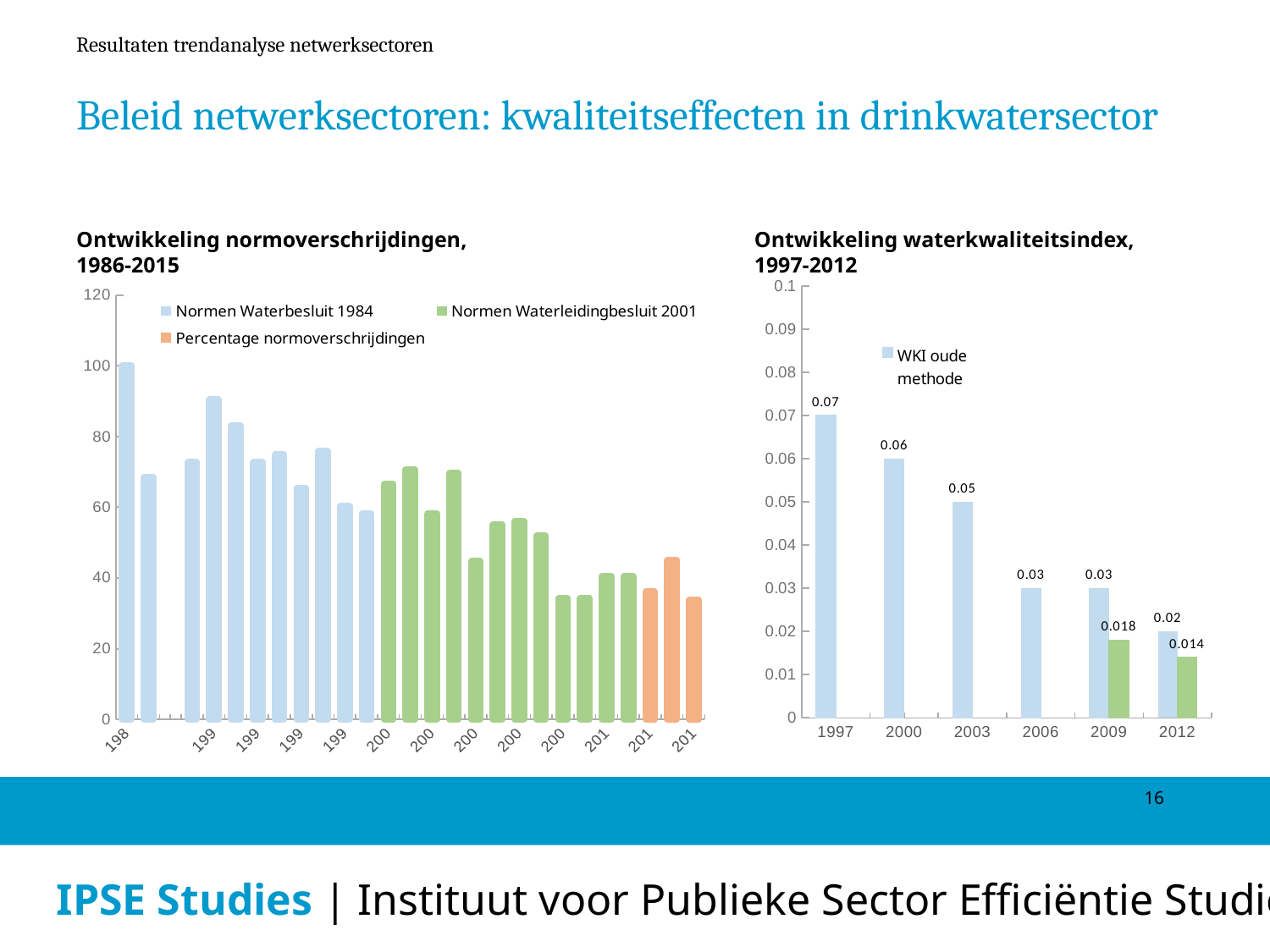
In the chart 'Ontwikkeling waterkwaliteitsindex, 1997-2012', what is the value of WKI oude methode for 2003? 0.05 How many years are shown on the x axis of the chart 'Ontwikkeling waterkwaliteitsindex, 1997-2012'? 6 In the chart 'Ontwikkeling waterkwaliteitsindex, 1997-2012', which year has the larger WKI oude methode value, 2000 or 2006? 2000 In the chart 'Ontwikkeling waterkwaliteitsindex, 1997-2012', what is the value of WKI oude methode for 1997? 0.07 What kind of chart is 'Ontwikkeling normoverschrijdingen, 1986-2015'? bar chart In the chart 'Ontwikkeling waterkwaliteitsindex, 1997-2012', what is the value of the green bar for 2009? 0.018 In the chart 'Ontwikkeling waterkwaliteitsindex, 1997-2012', what is the value of WKI oude methode for 2012? 0.02 How many series does the legend of the chart 'Ontwikkeling normoverschrijdingen, 1986-2015' list? 3 In the chart 'Ontwikkeling waterkwaliteitsindex, 1997-2012', what is the difference between the WKI oude methode values for 1997 and 2012? 0.05 In the chart 'Ontwikkeling normoverschrijdingen, 1986-2015', what colour represents 'Percentage normoverschrijdingen'? orange In the chart 'Ontwikkeling waterkwaliteitsindex, 1997-2012', do the WKI oude methode values rise or fall from 1997 to 2012? fall In the chart 'Ontwikkeling waterkwaliteitsindex, 1997-2012', which year has the highest WKI oude methode value? 1997